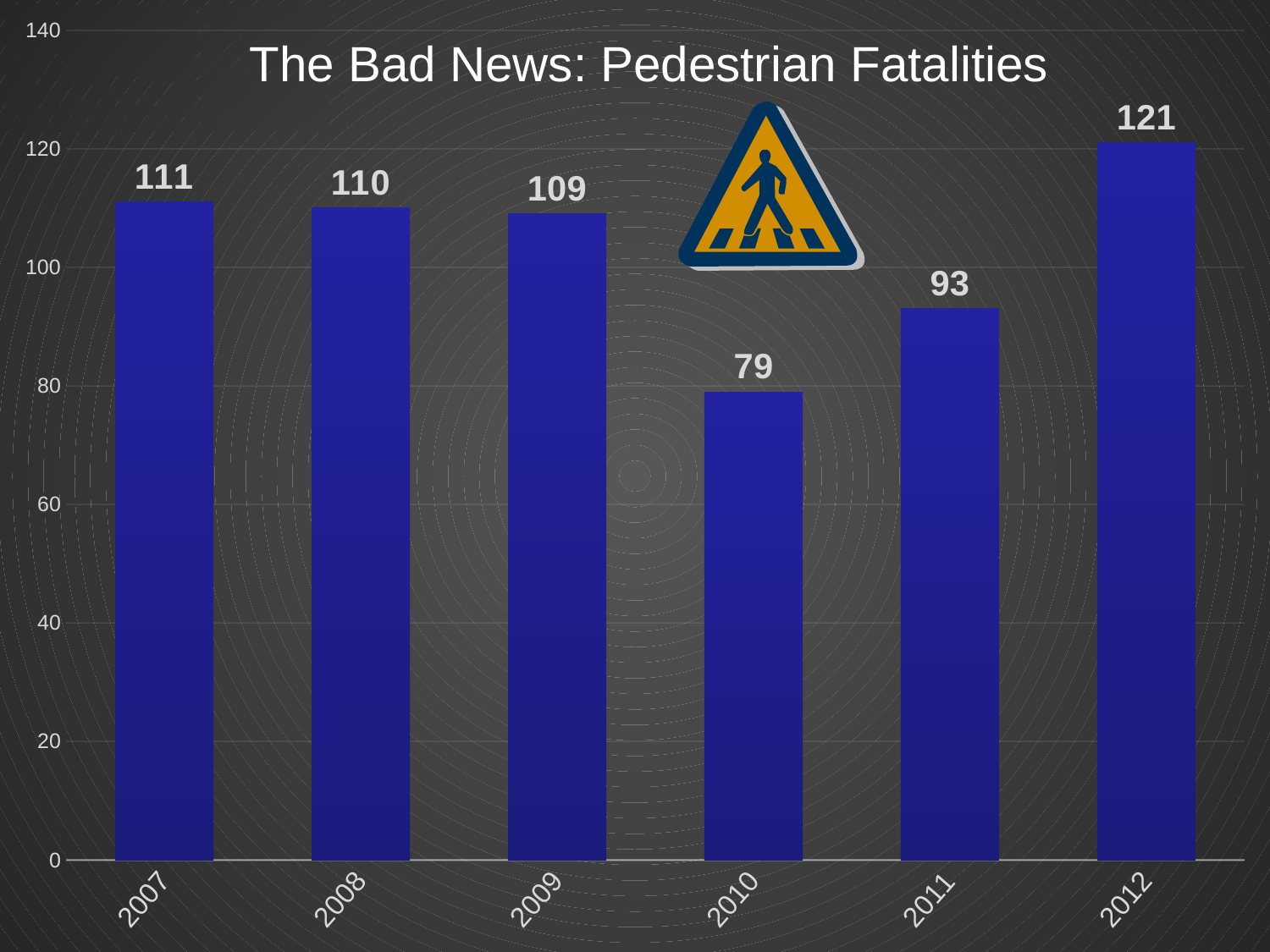
Which year has the highest value? 2012 What kind of chart is shown on the slide? bar chart What is the value for 2012? 121 What is the value for 2007? 111 Which is larger, the value for 2009 or the value for 2011? 2009 How many years are shown on the x axis? 6 Which year has the lowest value? 2010 Is the value for 2011 greater or less than 100? less What is the difference between the values for 2012 and 2010? 42 What is the value for 2010? 79 What is the title of the chart? The Bad News: Pedestrian Fatalities What is the difference between the values for 2011 and 2010? 14